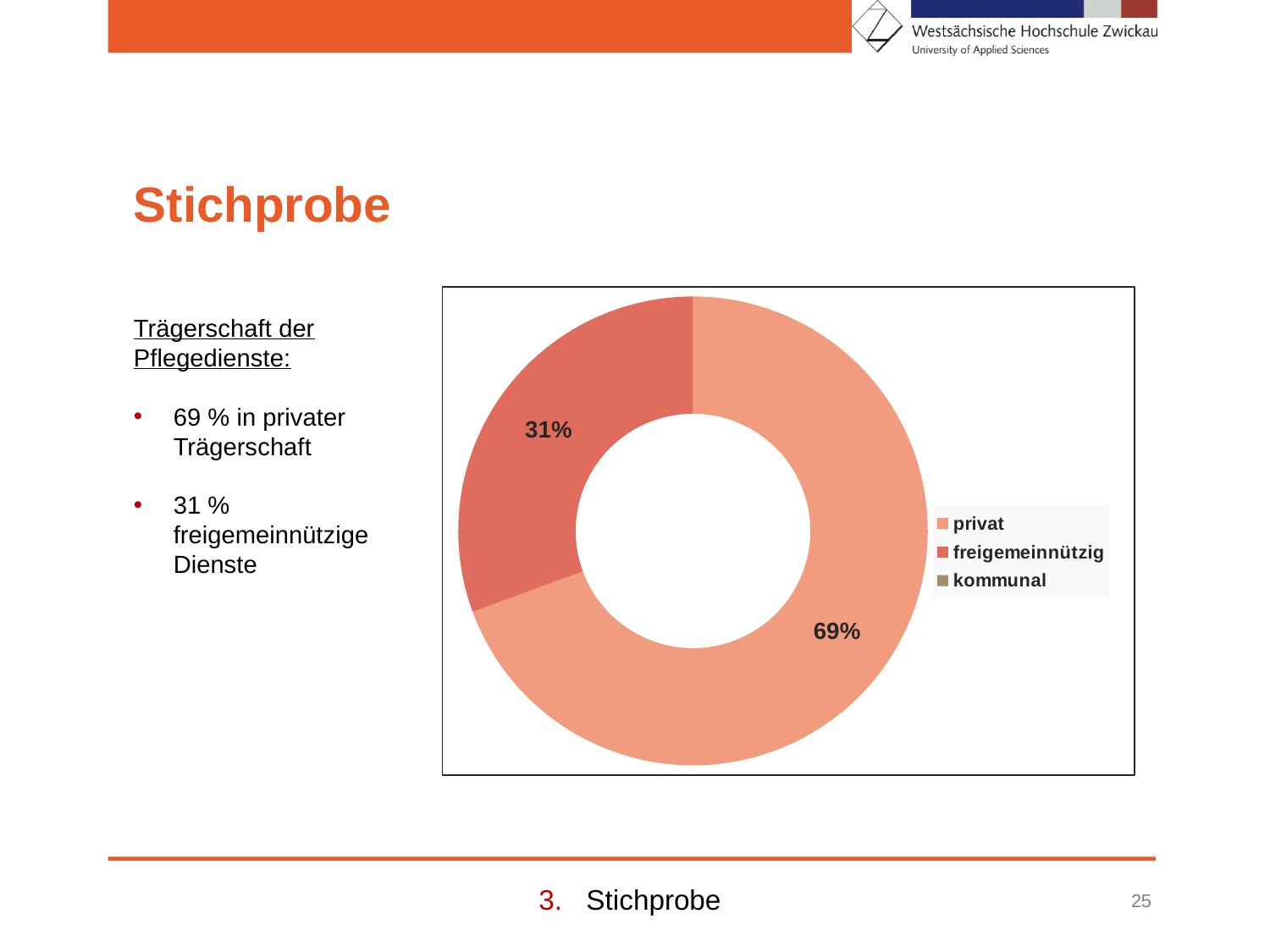
Which category has the largest share in the doughnut chart? privat What share of the doughnut chart is labelled "privat"? 69% What share of the doughnut chart is labelled "freigemeinnützig"? 31% What is the third entry listed in the chart legend? kommunal Which legend entry has no visible slice in the chart? kommunal How many entries does the chart legend list? 3 What kind of chart is shown on the slide? doughnut chart What is the combined share of the privat and freigemeinnützig slices? 100% By how many percentage points does the privat share exceed the freigemeinnützig share? 38 Which is larger, the share for privat or the share for freigemeinnützig? privat Which of the two visible slices is smaller, privat or freigemeinnützig? freigemeinnützig